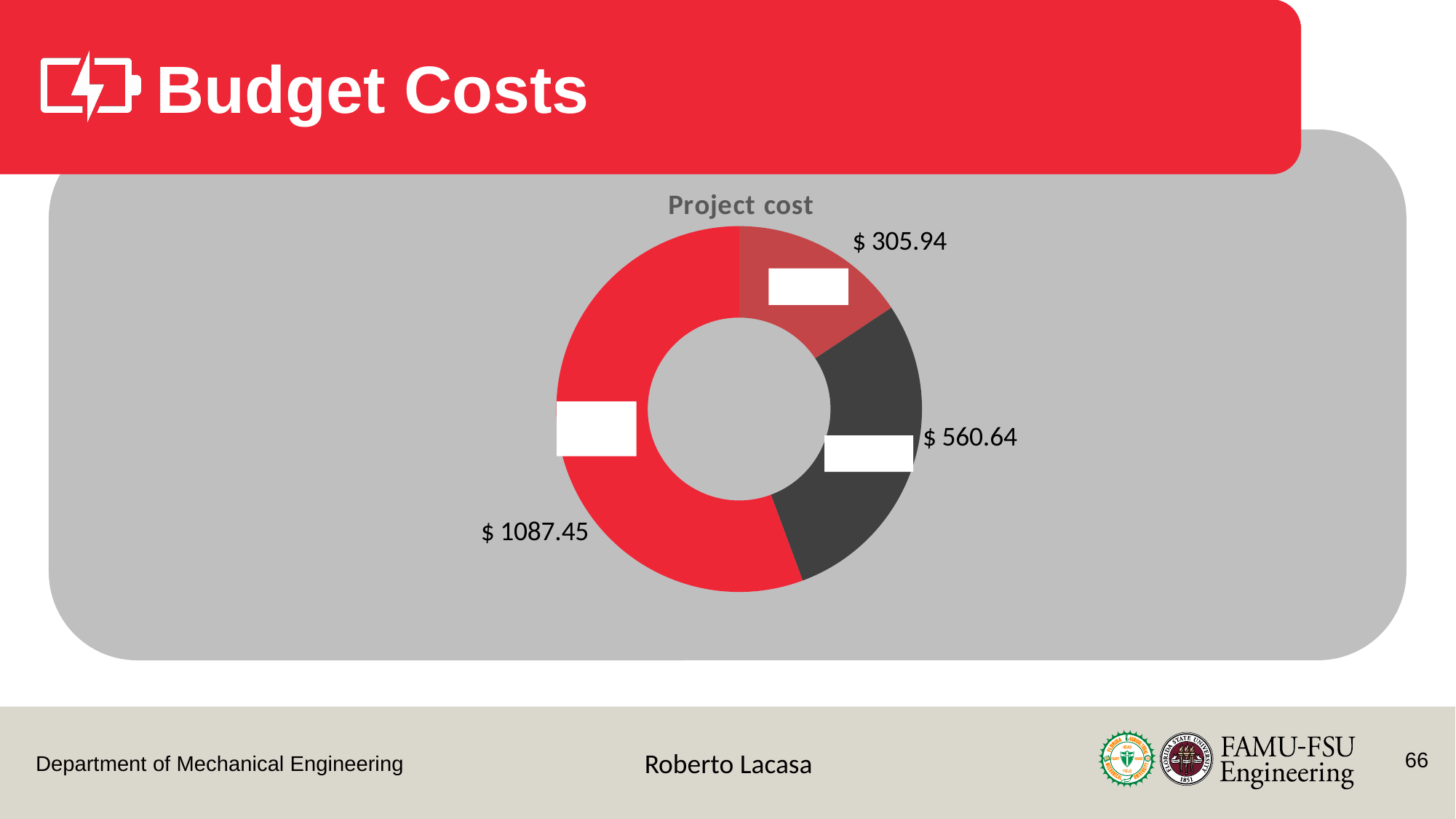
What share of the total project cost does the $ 1087.45 slice represent? 55.7% What kind of chart is shown on the slide? Doughnut (pie) chart What value is labelled on the dark gray slice of the Project cost chart? $ 560.64 Which slice is larger: the bright red slice or the dark gray slice? The bright red slice ($ 1087.45) What is the title of the chart? Project cost What is the total of all three slices in the Project cost chart? $ 1954.03 How many slices does the Project cost chart have? 3 What is the value of the largest slice in the Project cost chart? $ 1087.45 What value is labelled on the large bright red slice of the Project cost chart? $ 1087.45 What is the difference between the $ 560.64 slice and the $ 305.94 slice? $ 254.70 What is the value of the smallest slice in the Project cost chart? $ 305.94 What is the difference between the $ 1087.45 slice and the $ 560.64 slice? $ 526.81